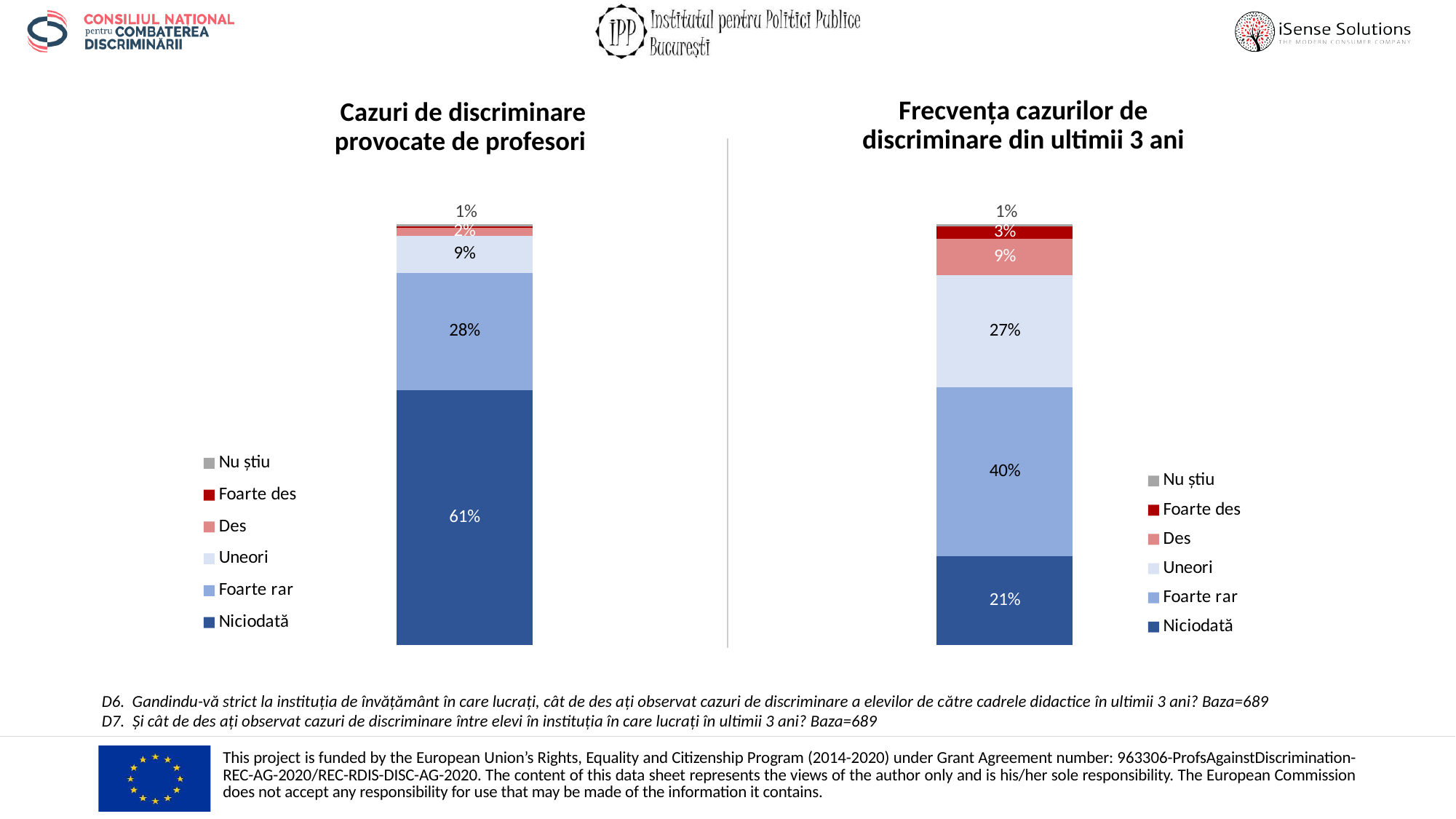
Which is larger: 'Niciodată' in the left chart or 'Niciodată' in the right chart? Niciodată in the left chart In the chart 'Frecvența cazurilor de discriminare din ultimii 3 ani', which category has the largest share? Foarte rar In the chart 'Frecvența cazurilor de discriminare din ultimii 3 ani', what is the difference between 'Foarte rar' and 'Uneori'? 13% In the chart 'Frecvența cazurilor de discriminare din ultimii 3 ani', what is the value for 'Niciodată'? 21% In the chart 'Cazuri de discriminare provocate de profesori', which category has the largest share? Niciodată In the chart 'Cazuri de discriminare provocate de profesori', what is the value for 'Uneori'? 9% In the chart 'Frecvența cazurilor de discriminare din ultimii 3 ani', what is the value for 'Foarte rar'? 40% In the chart 'Cazuri de discriminare provocate de profesori', what is the value for 'Foarte rar'? 28% How many categories does the legend of the chart 'Frecvența cazurilor de discriminare din ultimii 3 ani' list? 6 What kind of chart is 'Cazuri de discriminare provocate de profesori'? Stacked bar chart In the chart 'Cazuri de discriminare provocate de profesori', what is the value for 'Niciodată'? 61% In the chart 'Frecvența cazurilor de discriminare din ultimii 3 ani', what is the value for 'Des'? 9%